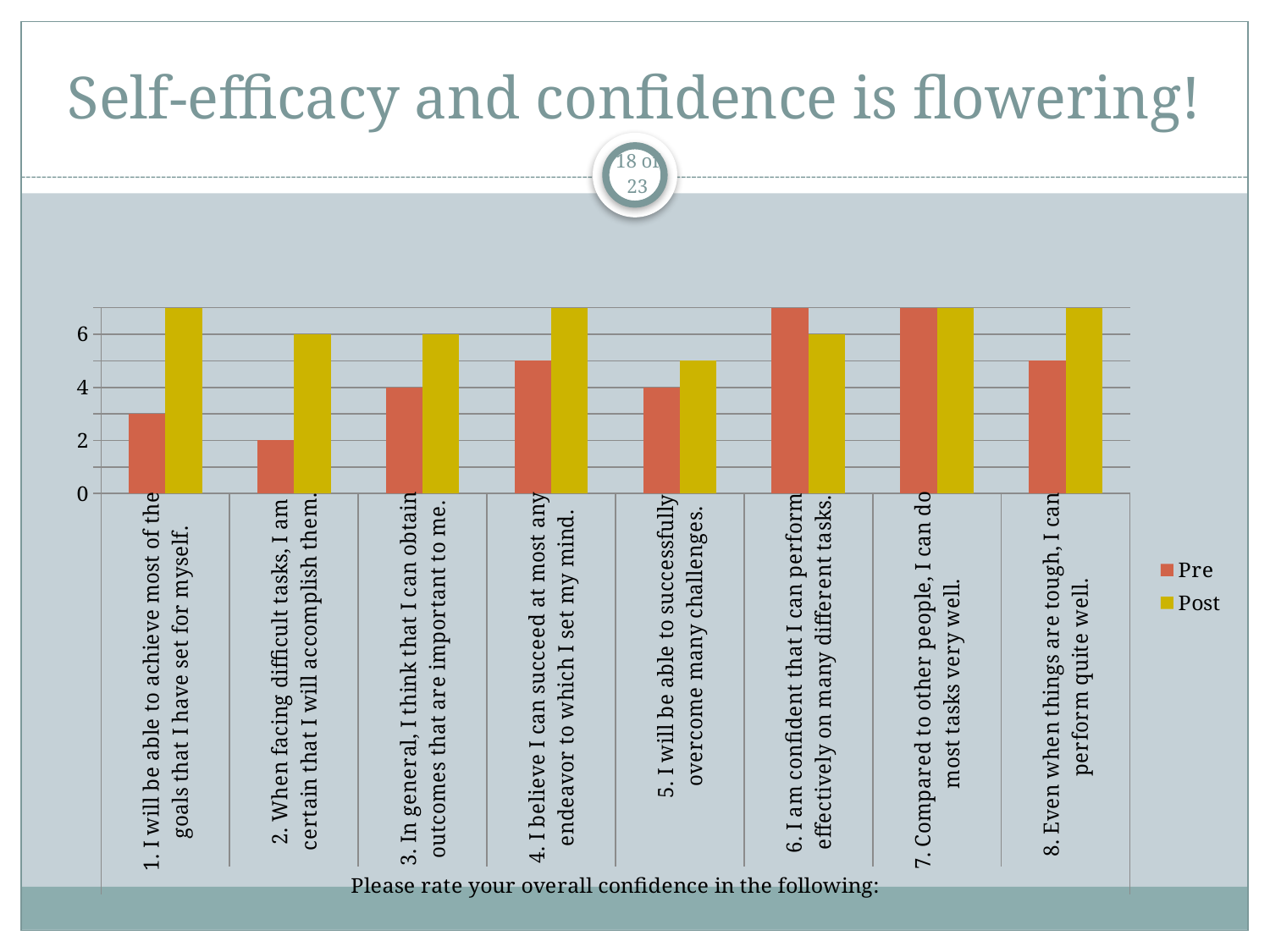
What is the Pre value for statement 2, "When facing difficult tasks, I am certain that I will accomplish them"? 2 How many statements (categories) are shown on the x axis of the chart? 8 What kind of chart is shown on the slide? bar chart What is the Post value for statement 6, "I am confident that I can perform effectively on many different tasks"? 6 How many series does the chart legend list? 2 Which statement has the lowest Pre value? 2. When facing difficult tasks, I am certain that I will accomplish them. What is the Post value for statement 3, "In general, I think that I can obtain outcomes that are important to me"? 6 What is the Pre value for statement 5, "I will be able to successfully overcome many challenges"? 4 Which series is shown in yellow in the chart? Post Is the Pre value for statement 1, "I will be able to achieve most of the goals that I have set for myself", greater or less than 4? less For statement 4, "I believe I can succeed at most any endeavor to which I set my mind", which is larger, the Pre value or the Post value? Post Is the Post value for statement 1, "I will be able to achieve most of the goals that I have set for myself", greater or less than 6? greater